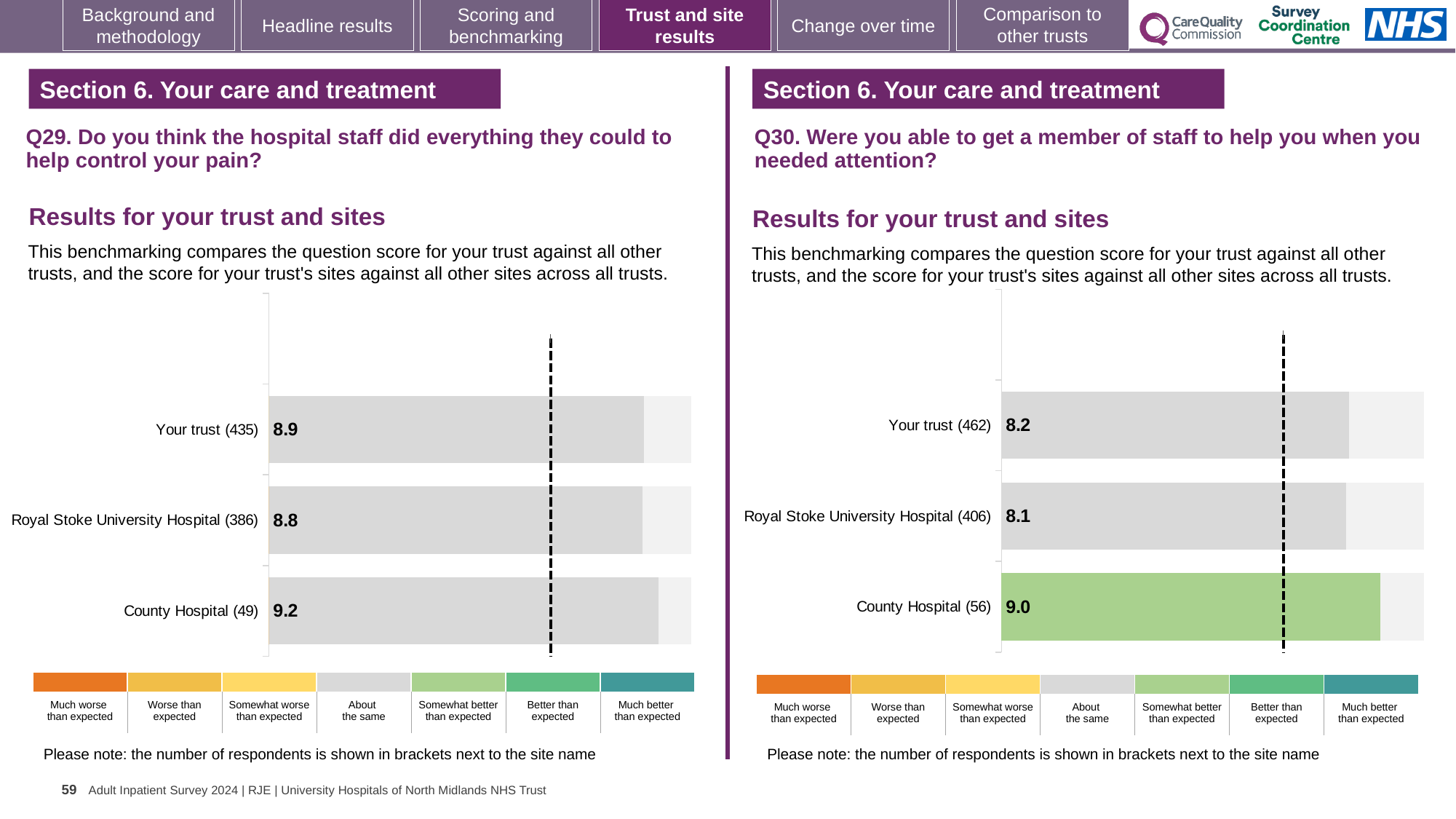
In the Q30 chart on the right, which benchmark category does the green colour of the County Hospital bar correspond to? Somewhat better than expected In the Q30 chart on the right, what is the difference between the County Hospital score and the Your trust score? 0.8 In the Q30 chart on the right, which site or trust has the highest score? County Hospital In the Q29 chart on the left, what is the score for Your trust? 8.9 In the Q29 chart on the left, which site or trust has the lowest score? Royal Stoke University Hospital In the Q29 chart on the left, what is the score for County Hospital? 9.2 In the Q30 chart on the right, what is the score for Royal Stoke University Hospital? 8.1 In the Q29 chart on the left, how many respondents are shown in brackets for Royal Stoke University Hospital? 386 In the Q30 chart on the right, which has the larger score, Your trust or Royal Stoke University Hospital? Your trust In the Q29 chart on the left, what is the difference between the County Hospital score and the Your trust score? 0.3 What type of chart is used for the Q29 results on the left? Bar chart How many bars are plotted in the Q30 chart on the right? 3